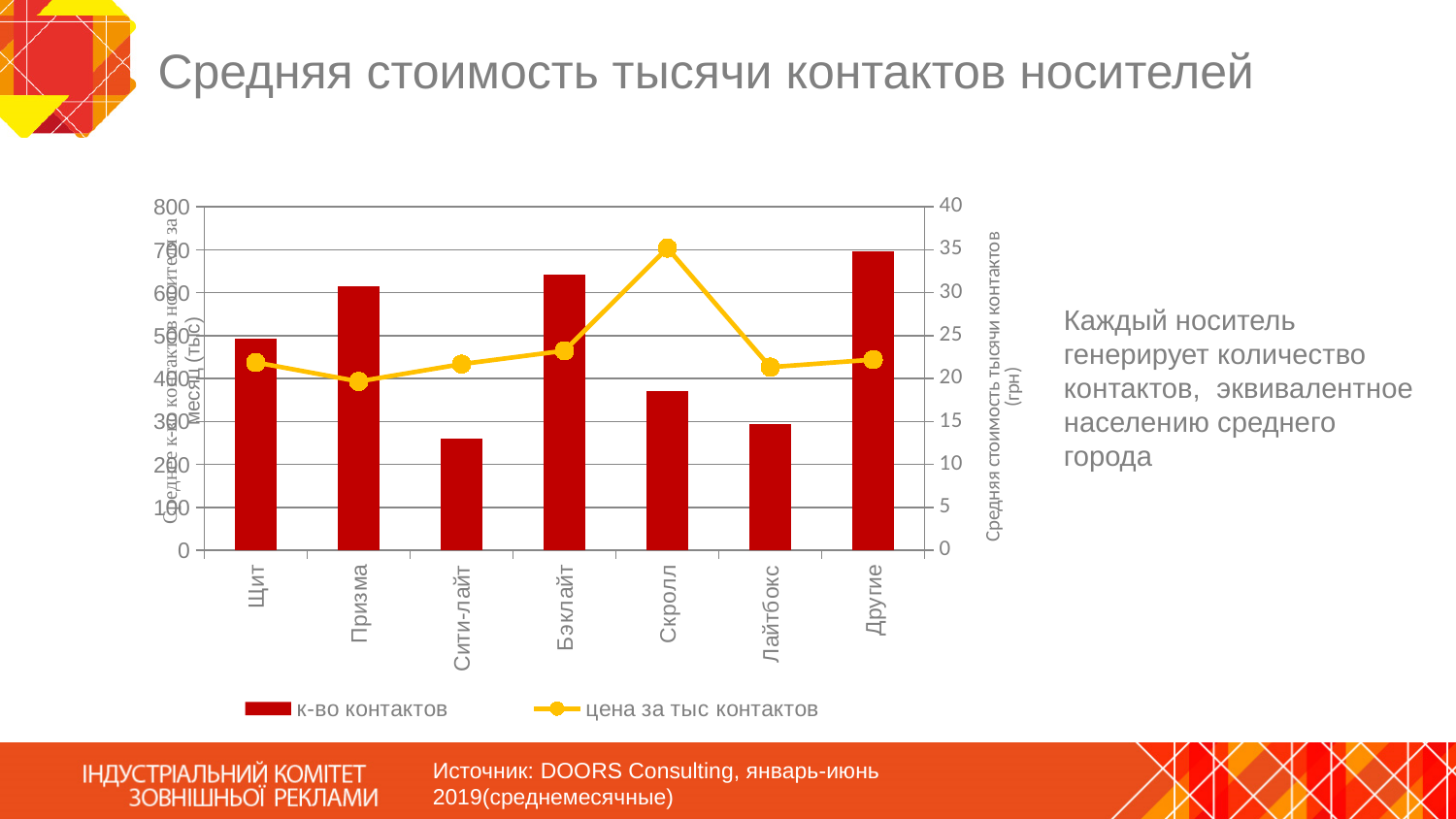
Which series is drawn as a line with markers in the chart? цена за тыс контактов Is the цена за тыс контактов value for Скролл greater or less than 30? greater Is the к-во контактов value for Сити-лайт greater or less than 300? less Which has the larger к-во контактов bar, Призма or Скролл? Призма Which category has the highest value on the цена за тыс контактов line? Скролл How many categories are shown on the x axis of the chart? 7 Is the к-во контактов value for Лайтбокс greater or less than 400? less What colour are the к-во контактов bars? Red Which category has the lowest bar for к-во контактов? Сити-лайт How many series does the chart legend list? 2 Which category has the highest bar for к-во контактов? Другие